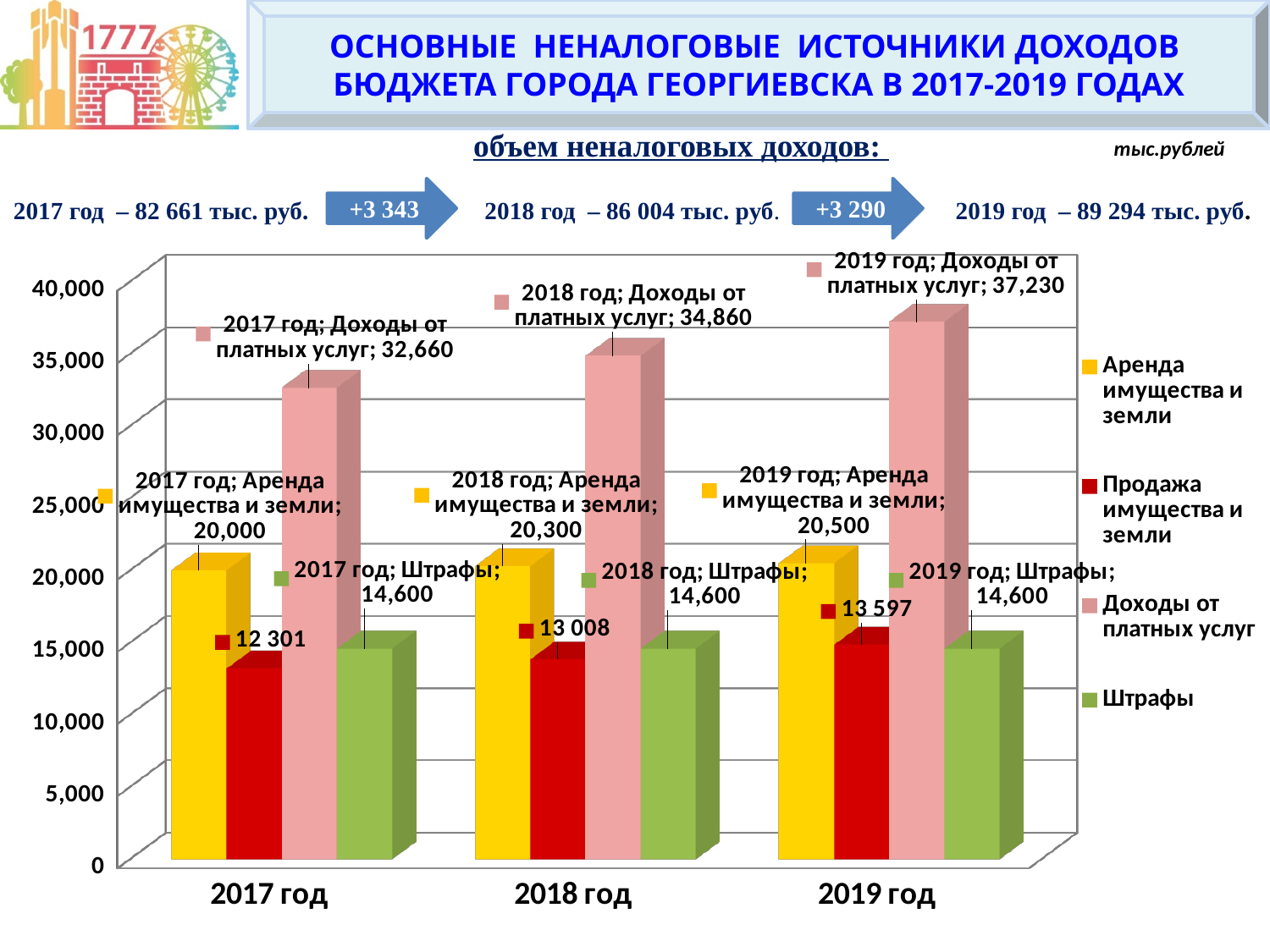
Which series has the highest value in 2019 год? Доходы от платных услуг Which series has the lowest value in 2017 год? Продажа имущества и земли What is the difference between Доходы от платных услуг in 2019 год and in 2018 год? 2,370 What is the value for Доходы от платных услуг in 2017 год? 32,660 What is the value for Аренда имущества и земли in 2019 год? 20,500 What is the value for Продажа имущества и земли in 2018 год? 13 008 Which is larger: Аренда имущества и земли in 2018 год or Штрафы in 2018 год? Аренда имущества и земли in 2018 год How many year categories are shown on the x axis? 3 What is the value for Штрафы in 2019 год? 14,600 Do the values for Доходы от платных услуг rise or fall from 2017 год to 2019 год? rise What kind of chart is shown on the slide? bar chart How many series does the legend list? 4